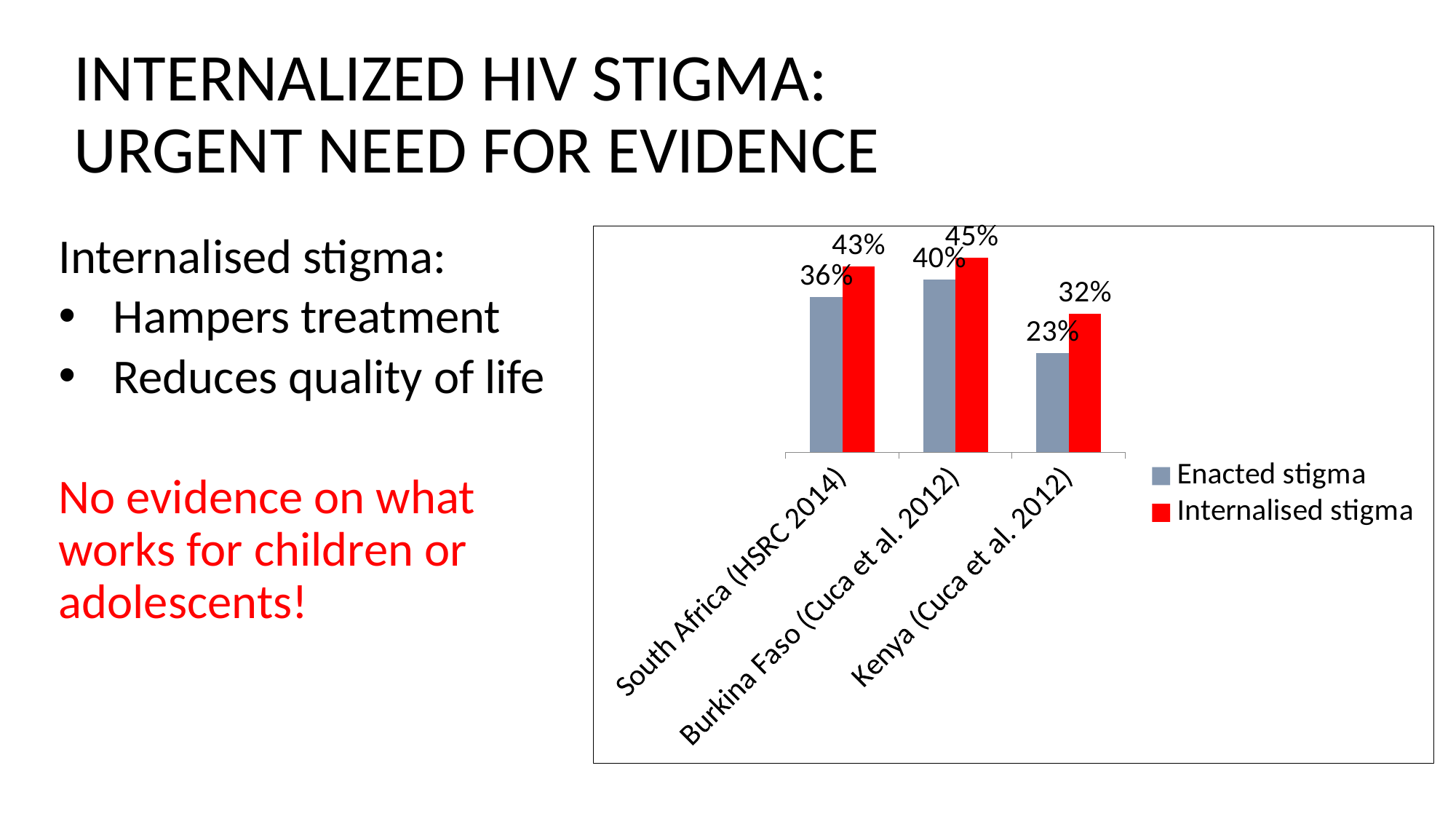
Which country has the highest Internalised stigma value? Burkina Faso (Cuca et al. 2012) What is the difference between the Internalised stigma values for Burkina Faso and South Africa? 2% What is the Internalised stigma value for South Africa (HSRC 2014)? 43% Which country has the lowest Enacted stigma value? Kenya (Cuca et al. 2012) How many countries are shown on the x axis of the chart? 3 What is the Enacted stigma value for Burkina Faso (Cuca et al. 2012)? 40% What is the Enacted stigma value for Kenya (Cuca et al. 2012)? 23% What colour are the Internalised stigma bars? Red What is the difference between Internalised stigma and Enacted stigma for Kenya (Cuca et al. 2012)? 9% Which is larger for South Africa (HSRC 2014): Enacted stigma or Internalised stigma? Internalised stigma What kind of chart is shown on the slide? Bar chart How many series does the chart legend list? 2